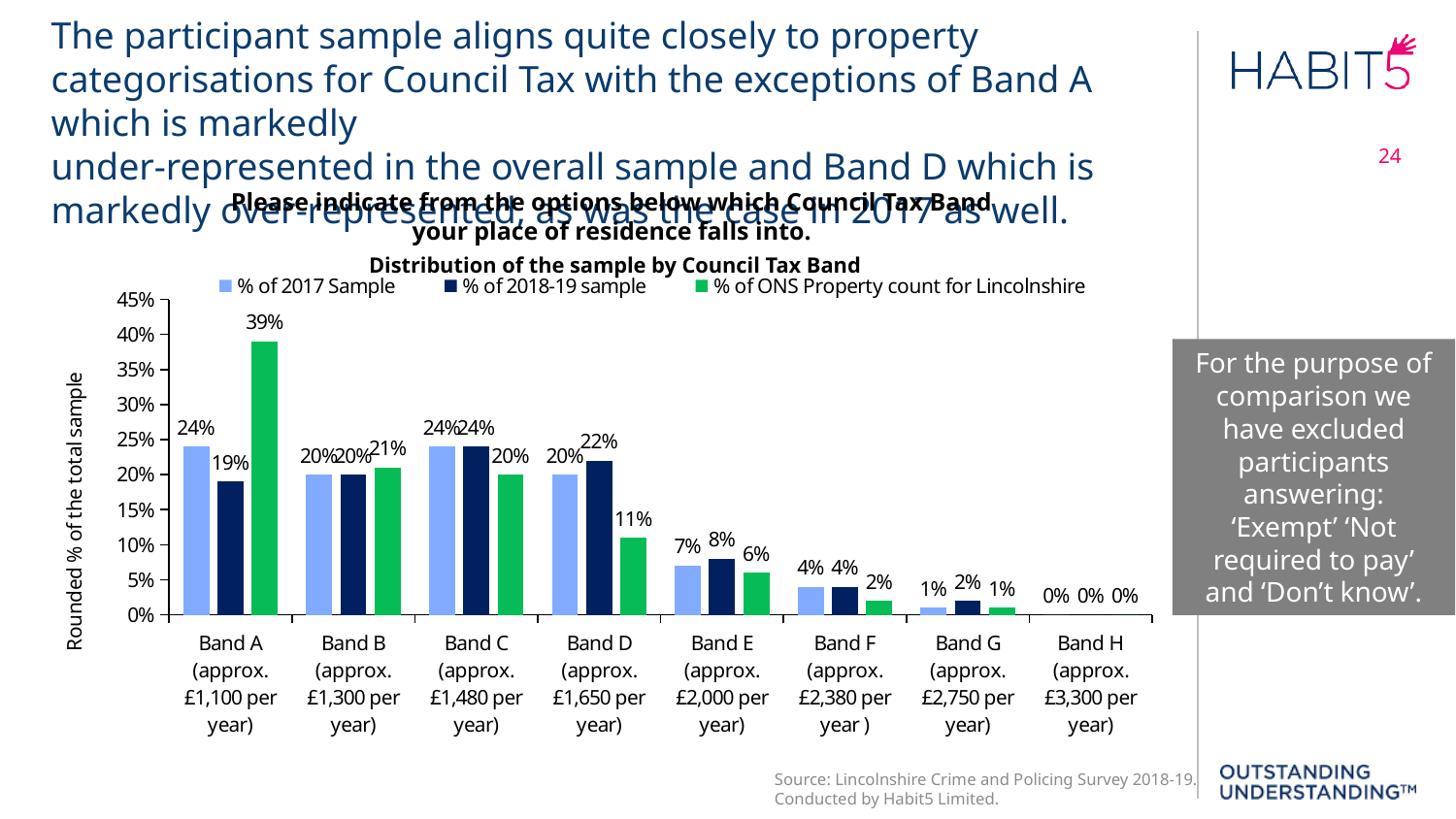
Do the % of 2017 Sample values generally rise or fall from Band D to Band H? Fall Which Council Tax Band has the highest % of ONS Property count for Lincolnshire? Band A What is the title of the chart? Distribution of the sample by Council Tax Band For Band D, which is larger: the % of 2018-19 sample or the % of ONS Property count for Lincolnshire? % of 2018-19 sample What is the % of 2017 Sample for Band E? 7% How many series does the legend list? 3 What is the % of ONS Property count for Lincolnshire for Band A? 39% What is the difference between the % of ONS Property count for Lincolnshire and the % of 2018-19 sample for Band A? 20% What is the % of 2018-19 sample for Band D? 22% What kind of chart is shown on the slide? Bar chart Which Council Tax Band has the lowest % of 2018-19 sample? Band H How many Council Tax Bands are shown on the x axis? 8